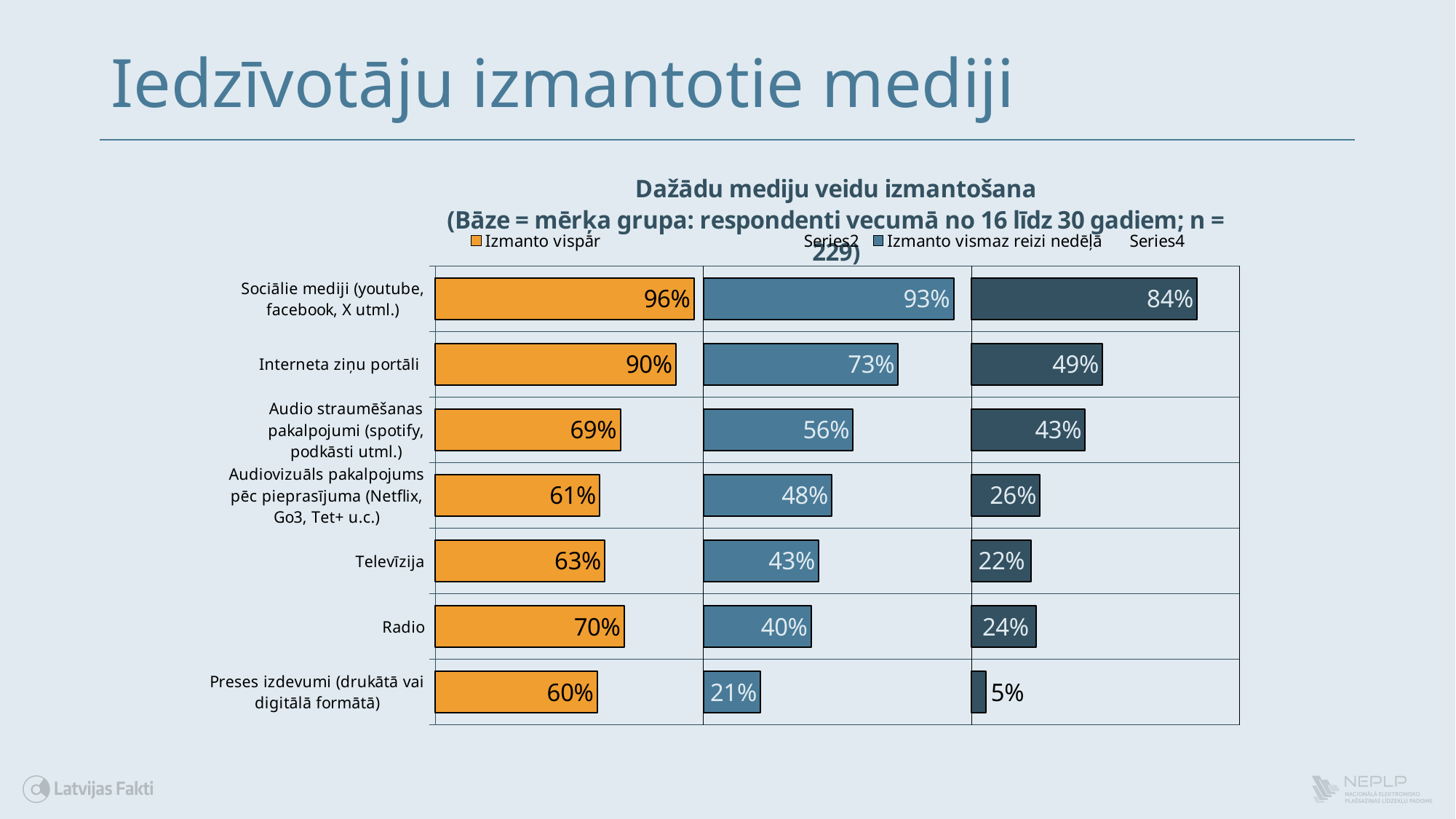
What is the "Izmanto vispār" value for Radio? 70% How many media categories are shown in the chart? 7 For Sociālie mediji, what is the difference between the "Izmanto vispār" value and the "Izmanto vismaz reizi nedēļā" value? 3 percentage points Which has the larger "Izmanto vispār" value, Radio or Televīzija? Radio What type of chart is shown on the slide? Bar chart Which category has the lowest "Izmanto vismaz reizi nedēļā" value? Preses izdevumi (drukātā vai digitālā formātā) Which category has the highest "Izmanto vispār" value? Sociālie mediji (youtube, facebook, X utml.) What is the "Izmanto vismaz reizi nedēļā" value for Televīzija? 43% What colour are the "Izmanto vispār" bars? Orange What is the value of the dark blue (third) bar for Interneta ziņu portāli? 49% What is the value of the dark blue (third) bar for Preses izdevumi (drukātā vai digitālā formātā)? 5% For Interneta ziņu portāli, how much higher is the "Izmanto vispār" value than the "Izmanto vismaz reizi nedēļā" value? 17 percentage points